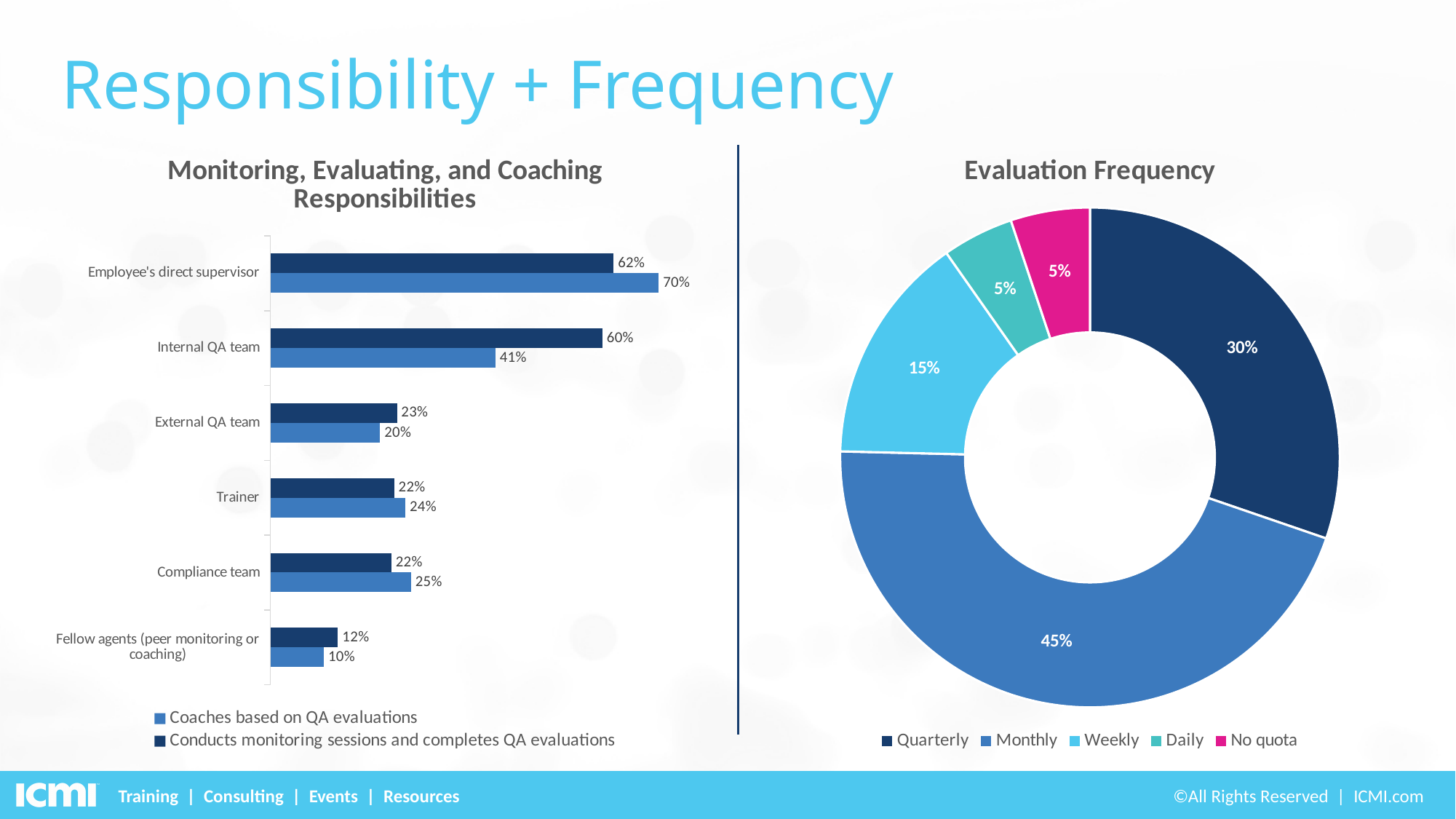
In the Evaluation Frequency chart, what share is Monthly? 45% In the Monitoring, Evaluating, and Coaching Responsibilities chart, which is larger for Compliance team: 'Coaches based on QA evaluations' or 'Conducts monitoring sessions and completes QA evaluations'? Coaches based on QA evaluations In the Evaluation Frequency chart, what is the difference between the Quarterly and Weekly shares? 15% In the Evaluation Frequency chart, which category has the largest share? Monthly In the Monitoring, Evaluating, and Coaching Responsibilities chart, what is the value for Internal QA team for 'Conducts monitoring sessions and completes QA evaluations'? 60% How many categories are shown in the Monitoring, Evaluating, and Coaching Responsibilities chart? 6 In the Monitoring, Evaluating, and Coaching Responsibilities chart, what percentage of employee's direct supervisors coach based on QA evaluations? 70% How many series does the legend of the Monitoring, Evaluating, and Coaching Responsibilities chart list? 2 In the Monitoring, Evaluating, and Coaching Responsibilities chart, which category has the lowest value for 'Coaches based on QA evaluations'? Fellow agents (peer monitoring or coaching) In the Monitoring, Evaluating, and Coaching Responsibilities chart, what is the difference between the two values for Internal QA team? 19% How many categories does the legend of the Evaluation Frequency chart list? 5 What kind of chart is the Monitoring, Evaluating, and Coaching Responsibilities chart? Bar chart